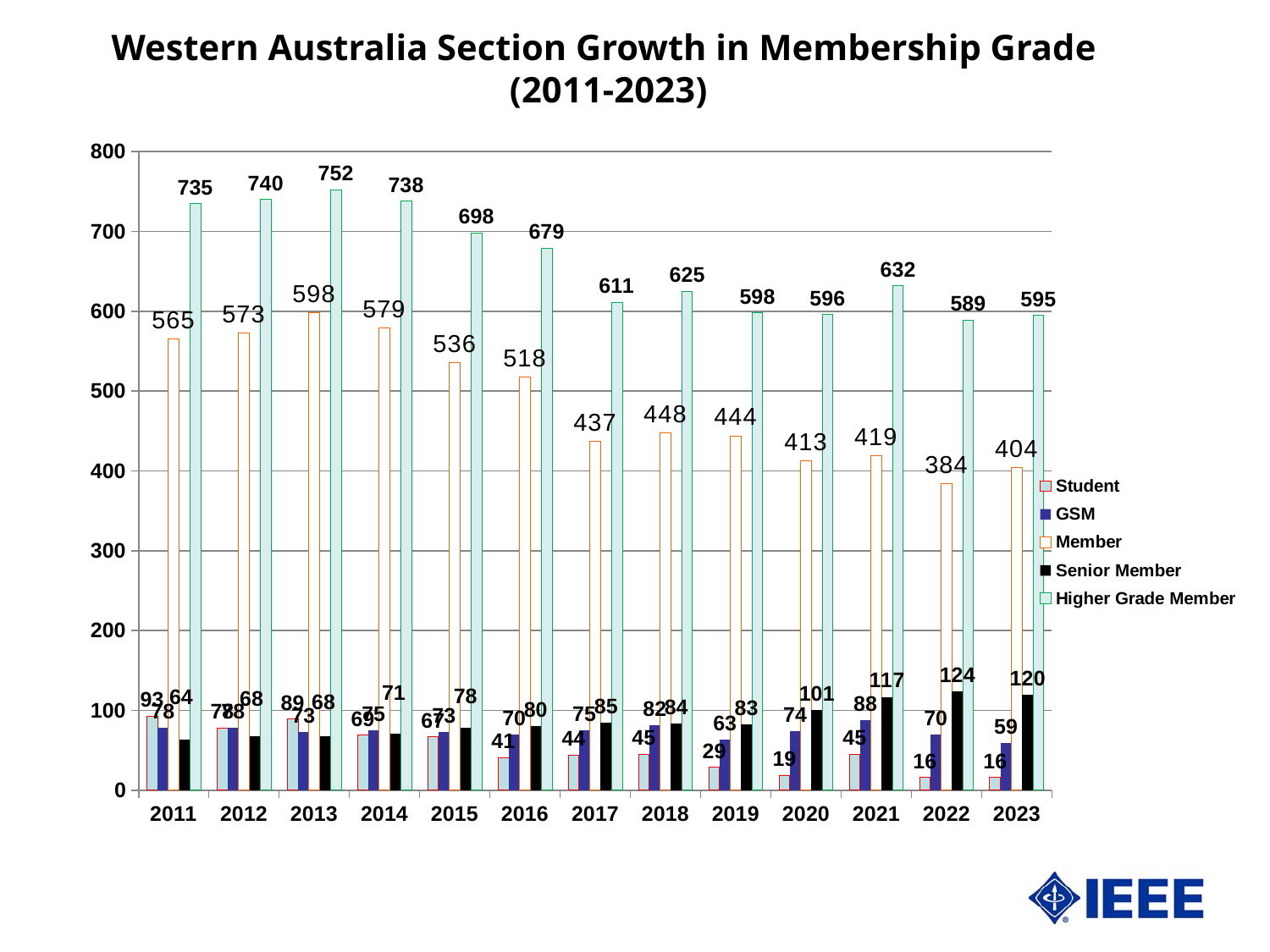
What is the Student value for 2019? 29 Which year has the larger Member value, 2013 or 2014? 2013 Does the Member value generally rise or fall from 2011 to 2023? fall In which year is the Higher Grade Member value highest? 2013 How many years are shown on the x axis? 13 What is the Senior Member value for 2022? 124 What is the difference between the Higher Grade Member values for 2011 and 2023? 140 How many series does the legend list? 5 In which year is the Member value lowest? 2022 What kind of chart is shown on the slide? bar chart In which year is the Senior Member value highest? 2022 What is the Higher Grade Member value for 2013? 752